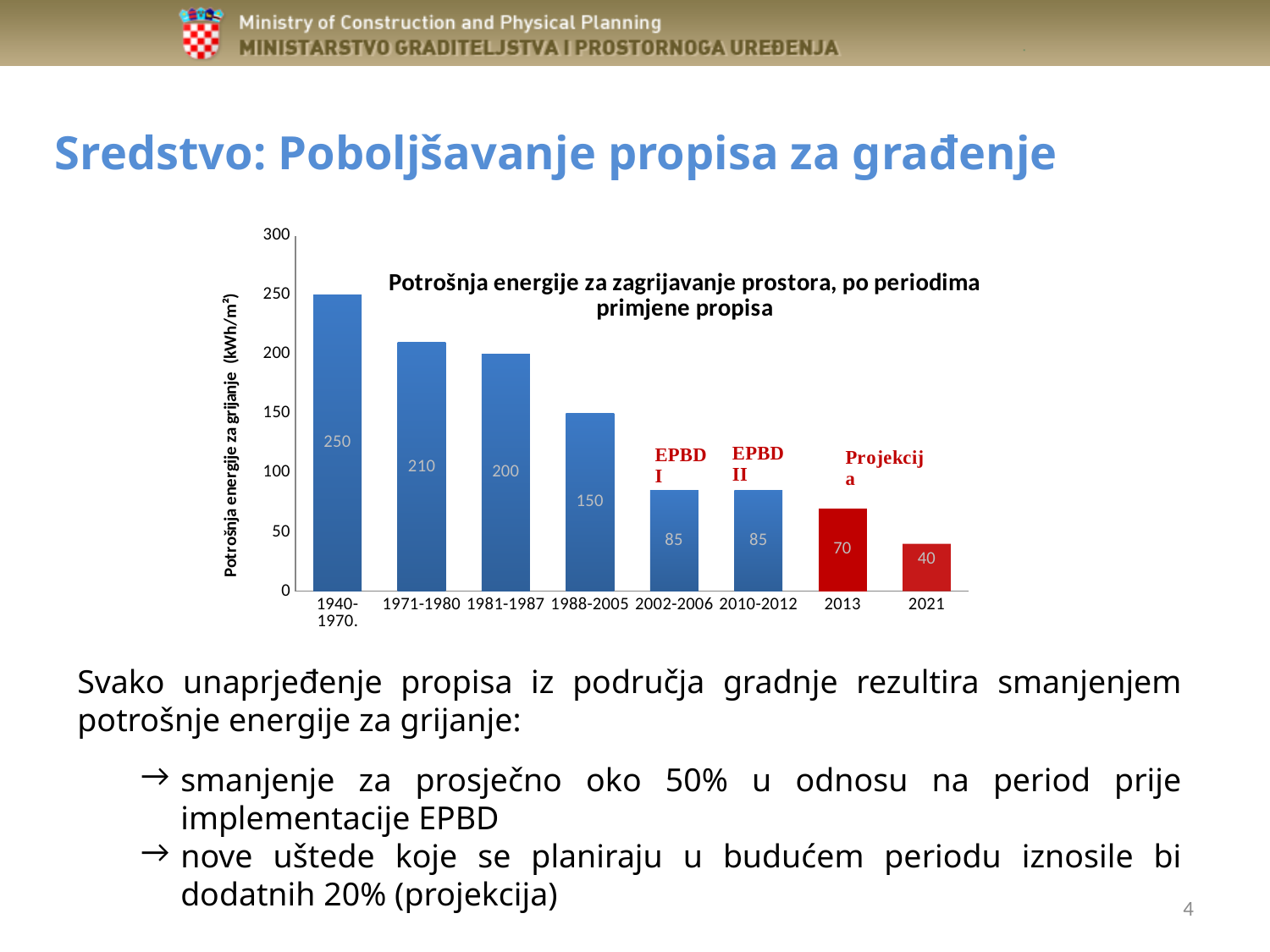
What is the value for the 1940-1970 period? 250 What is the value for the 1988-2005 period? 150 How many periods are shown on the x axis? 8 What kind of chart is shown on the slide? bar chart What is the difference between the values for 2013 and 2021? 30 What is the value for 2021? 40 Is the value for 2010-2012 greater or less than 100? less What is the difference between the values for 1971-1980 and 1981-1987? 10 Which period has the highest energy consumption for heating? 1940-1970 Do the values rise or fall from left to right along the x axis? fall Which is larger, the value for 1988-2005 or the value for 2002-2006? 1988-2005 Which period has the lowest energy consumption for heating? 2021